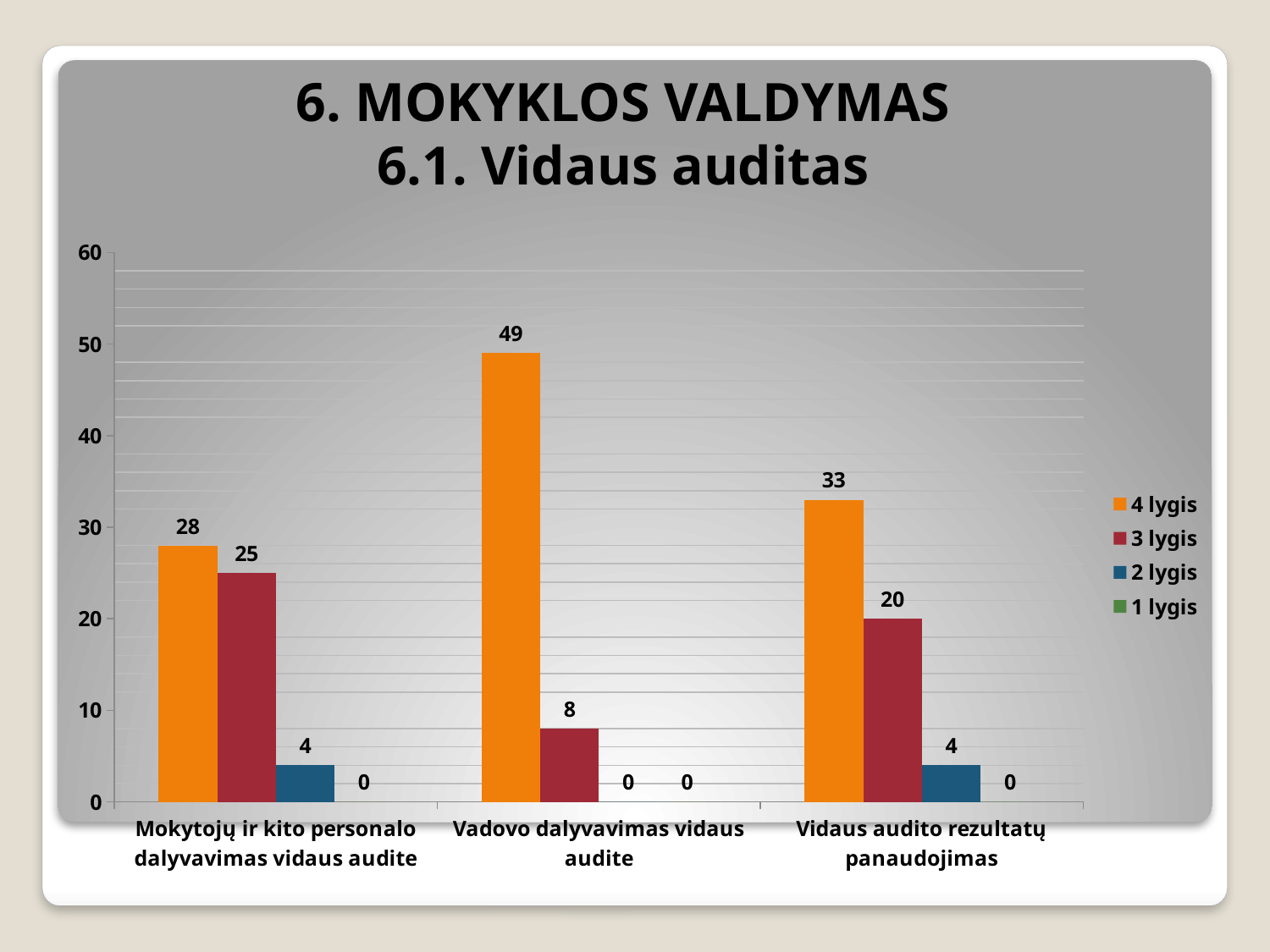
What is the difference between the "4 lygis" and "3 lygis" values for "Vidaus audito rezultatų panaudojimas"? 13 Which category has the highest "4 lygis" value? Vadovo dalyvavimas vidaus audite How many series does the legend list? 4 Is the "4 lygis" value for "Vadovo dalyvavimas vidaus audite" greater or less than 40? greater What is the value of the "4 lygis" series for "Vadovo dalyvavimas vidaus audite"? 49 What kind of chart is shown on the slide? bar chart Which is larger: the "4 lygis" value for "Mokytojų ir kito personalo dalyvavimas vidaus audite" or the "4 lygis" value for "Vidaus audito rezultatų panaudojimas"? Vidaus audito rezultatų panaudojimas What is the value of the "3 lygis" series for "Vadovo dalyvavimas vidaus audite"? 8 Which category has the lowest "3 lygis" value? Vadovo dalyvavimas vidaus audite What is the value of the "3 lygis" series for "Mokytojų ir kito personalo dalyvavimas vidaus audite"? 25 How many categories are shown on the x axis? 3 What is the value of the "2 lygis" series for "Vidaus audito rezultatų panaudojimas"? 4